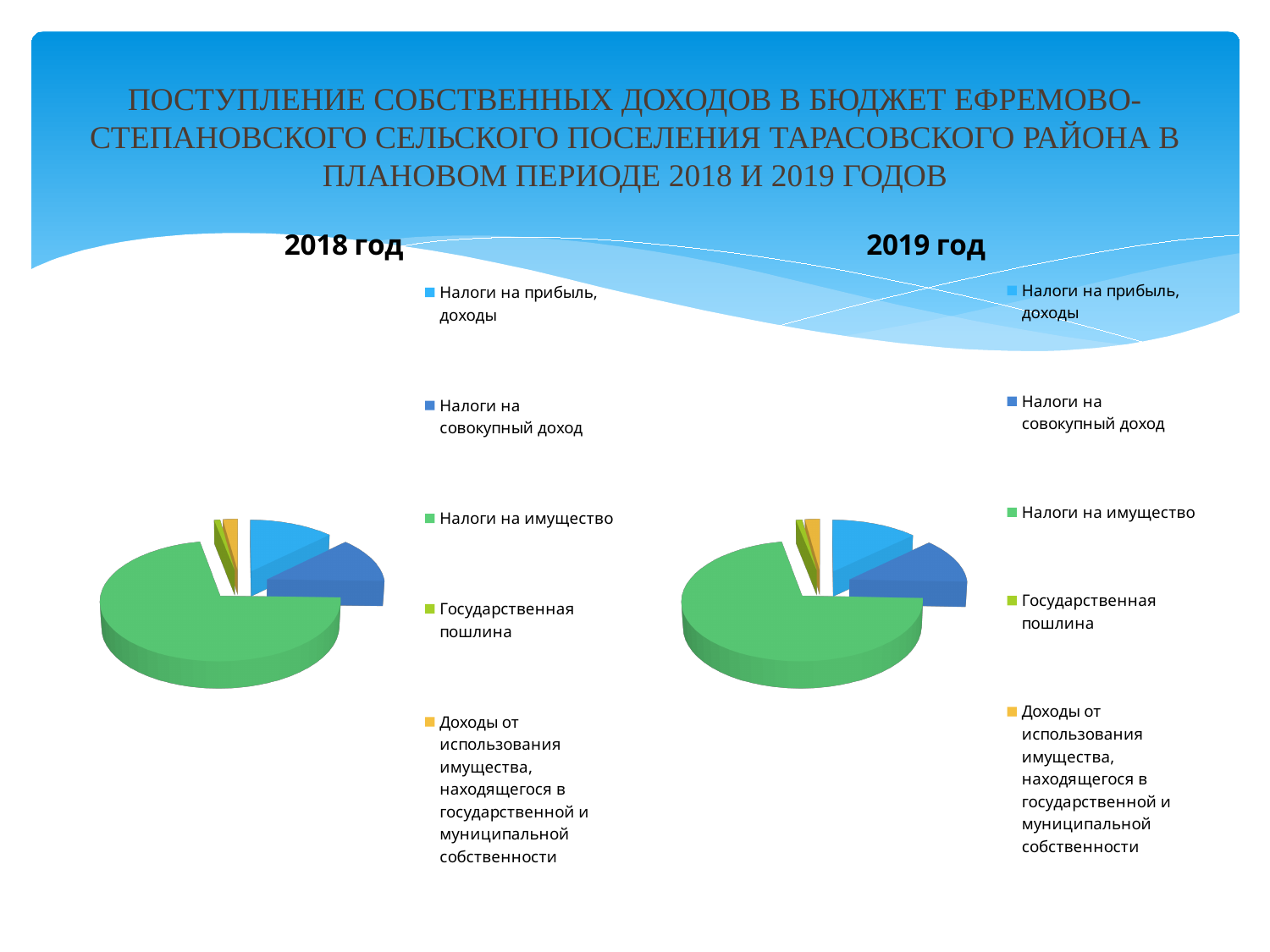
What kind of chart is the "2019 год" chart? pie chart What colour is the "Налоги на имущество" slice in the "2019 год" chart? green How many categories does the legend of the "2019 год" chart list? 5 In the "2019 год" chart, which slice is larger: "Налоги на совокупный доход" or "Государственная пошлина"? Налоги на совокупный доход What kind of chart is the "2018 год" chart? pie chart In the "2018 год" chart, which slice is larger: "Налоги на прибыль, доходы" or "Доходы от использования имущества, находящегося в государственной и муниципальной собственности"? Налоги на прибыль, доходы In the "2018 год" chart, which slice is larger: "Налоги на имущество" or "Налоги на прибыль, доходы"? Налоги на имущество What is the title shown above the left pie chart? 2018 год How many categories does the legend of the "2018 год" chart list? 5 In the "2018 год" chart, which category has the largest slice? Налоги на имущество In the "2019 год" chart, which category has the largest slice? Налоги на имущество